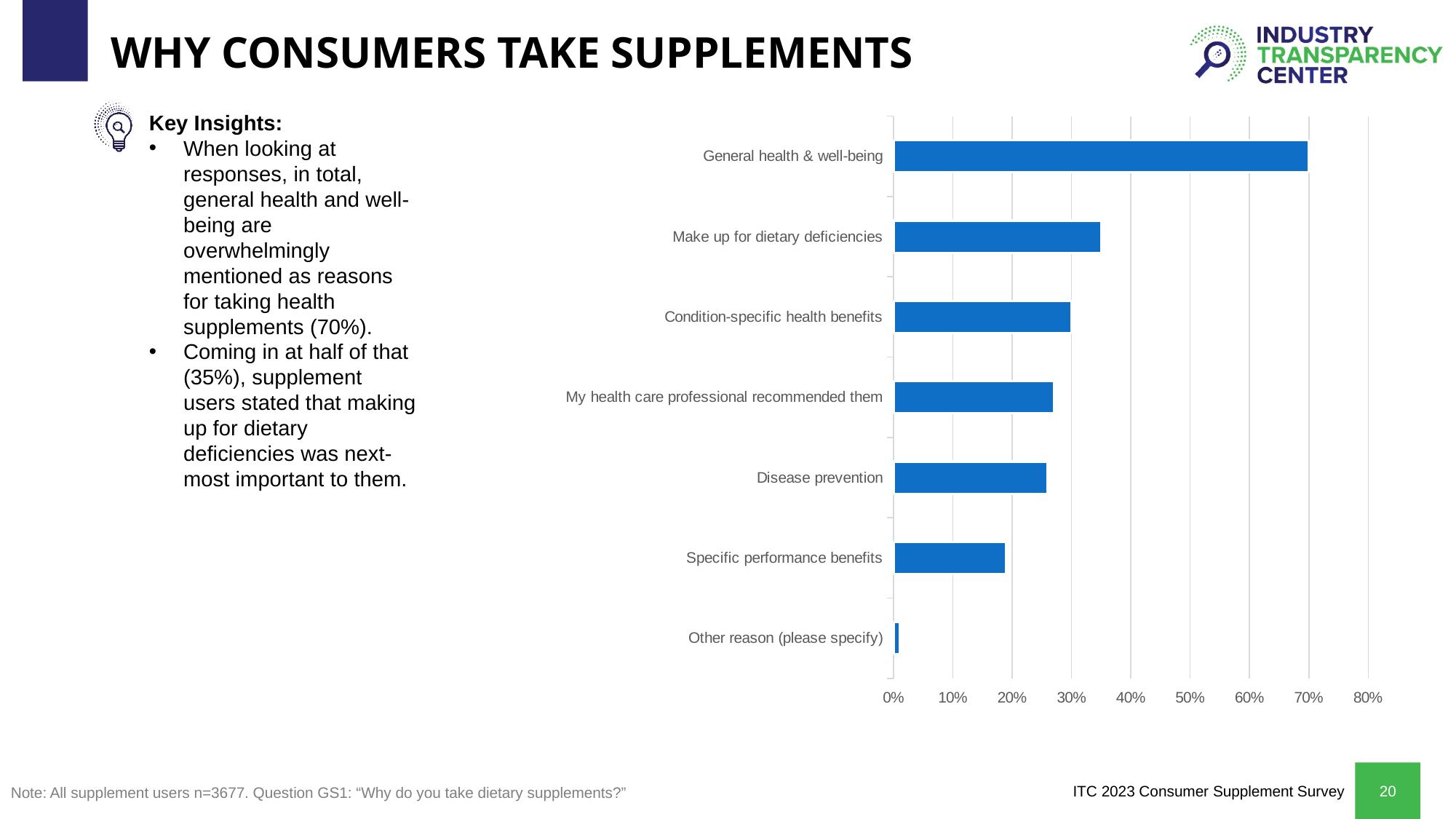
Which reason has the lowest share of responses? Other reason (please specify) Is the value for Other reason (please specify) greater or less than 10%? less How many reasons for taking supplements are plotted in the chart? 7 Is the value for My health care professional recommended them greater or less than 20%? greater What percentage of supplement users cited general health & well-being as a reason? 70% Which reason has the highest share of responses? General health & well-being Which is larger: the value for Make up for dietary deficiencies or the value for Disease prevention? Make up for dietary deficiencies What is the highest value shown on the horizontal axis of the chart? 80% What percentage of supplement users cited making up for dietary deficiencies? 35% Is the value for Disease prevention greater or less than 40%? less What is the difference between the share for general health & well-being and the share for making up for dietary deficiencies? 35% What kind of chart is shown on the slide? bar chart